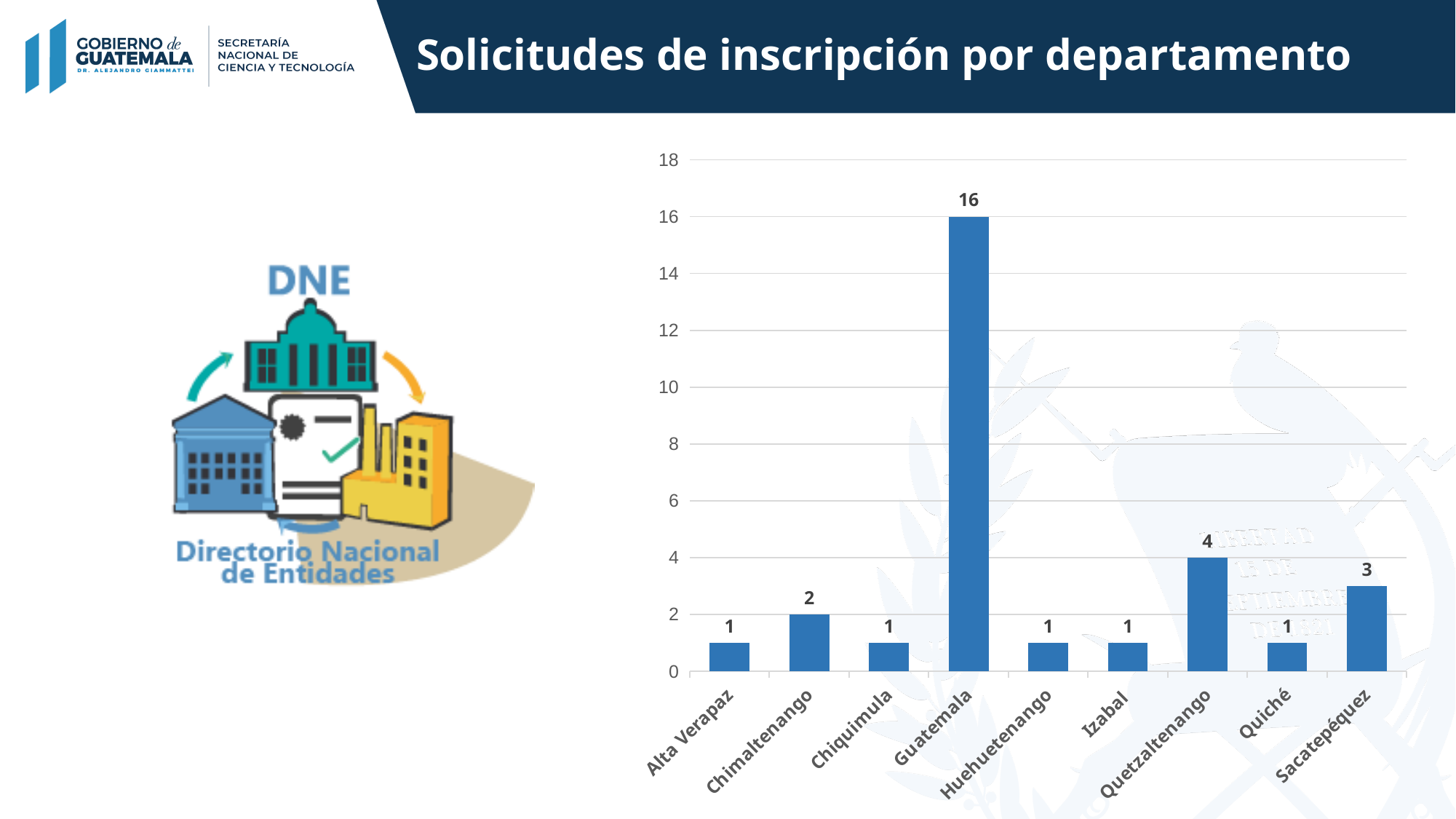
Which is larger, the value for Sacatepéquez or the value for Chimaltenango? Sacatepéquez How many departments have a value of 1? 5 What is the value for Guatemala? 16 What is the value for Sacatepéquez? 3 How many departments are shown on the x axis? 9 What is the value for Quetzaltenango? 4 Which department has the highest value? Guatemala What is the value for Chimaltenango? 2 What is the title of the slide containing the chart? Solicitudes de inscripción por departamento Is the value for Guatemala greater or less than 10? greater What is the difference between the values for Guatemala and Quetzaltenango? 12 What kind of chart is shown on the slide? Bar chart